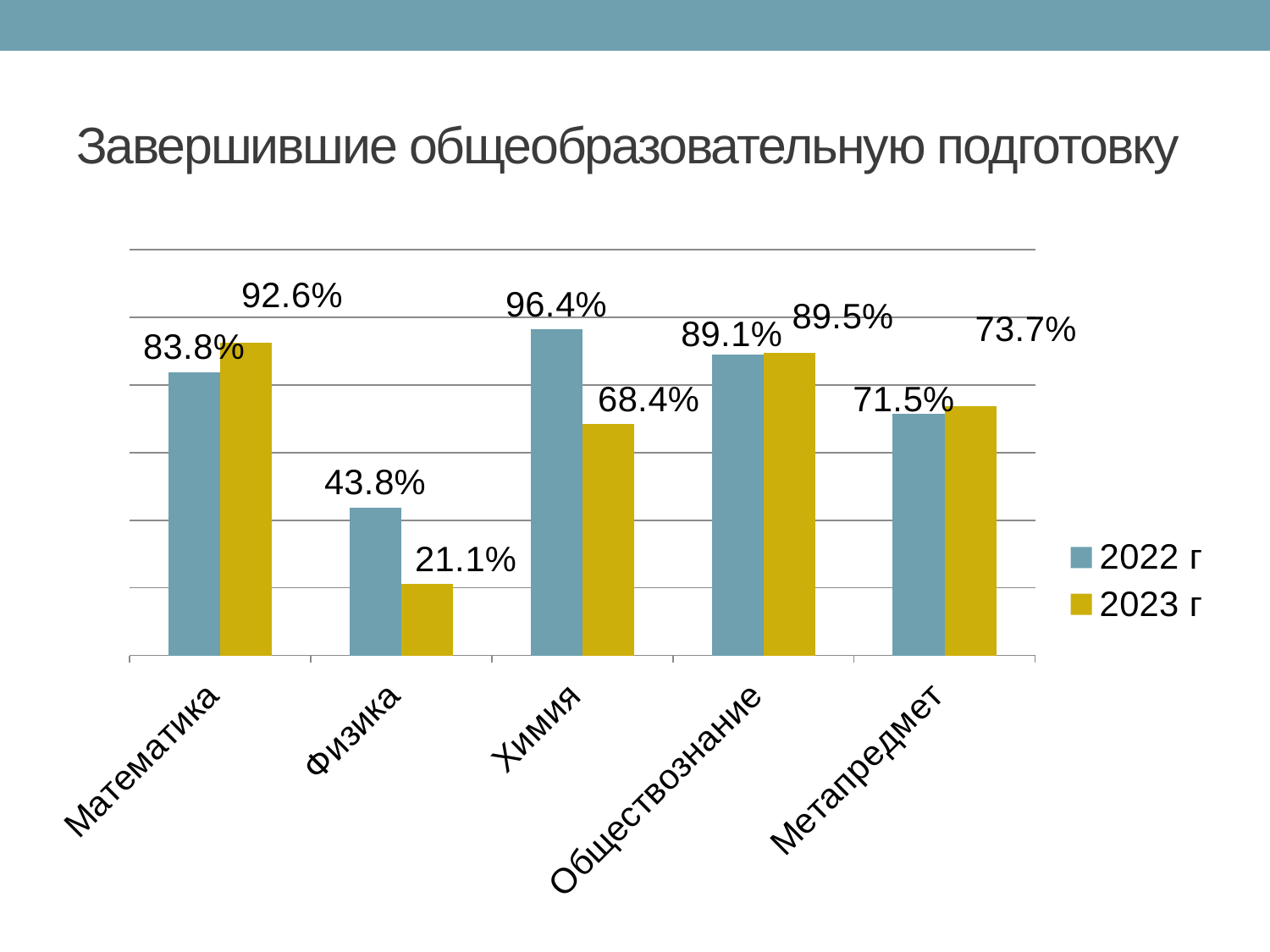
What is the value for Химия in the 2023 г series? 68.4% What is the value for Физика in the 2023 г series? 21.1% How many categories are shown on the x axis? 5 Which is larger for Математика: the 2022 г value or the 2023 г value? 2023 г What is the difference between the 2022 г and 2023 г values for Химия? 28.0% What is the value for Математика in the 2022 г series? 83.8% What is the value for Метапредмет in the 2022 г series? 71.5% What kind of chart is shown on the slide? Bar chart Which category has the lowest value in the 2023 г series? Физика Which category has the highest value in the 2022 г series? Химия How many series does the legend list? 2 What is the title of the slide? Завершившие общеобразовательную подготовку